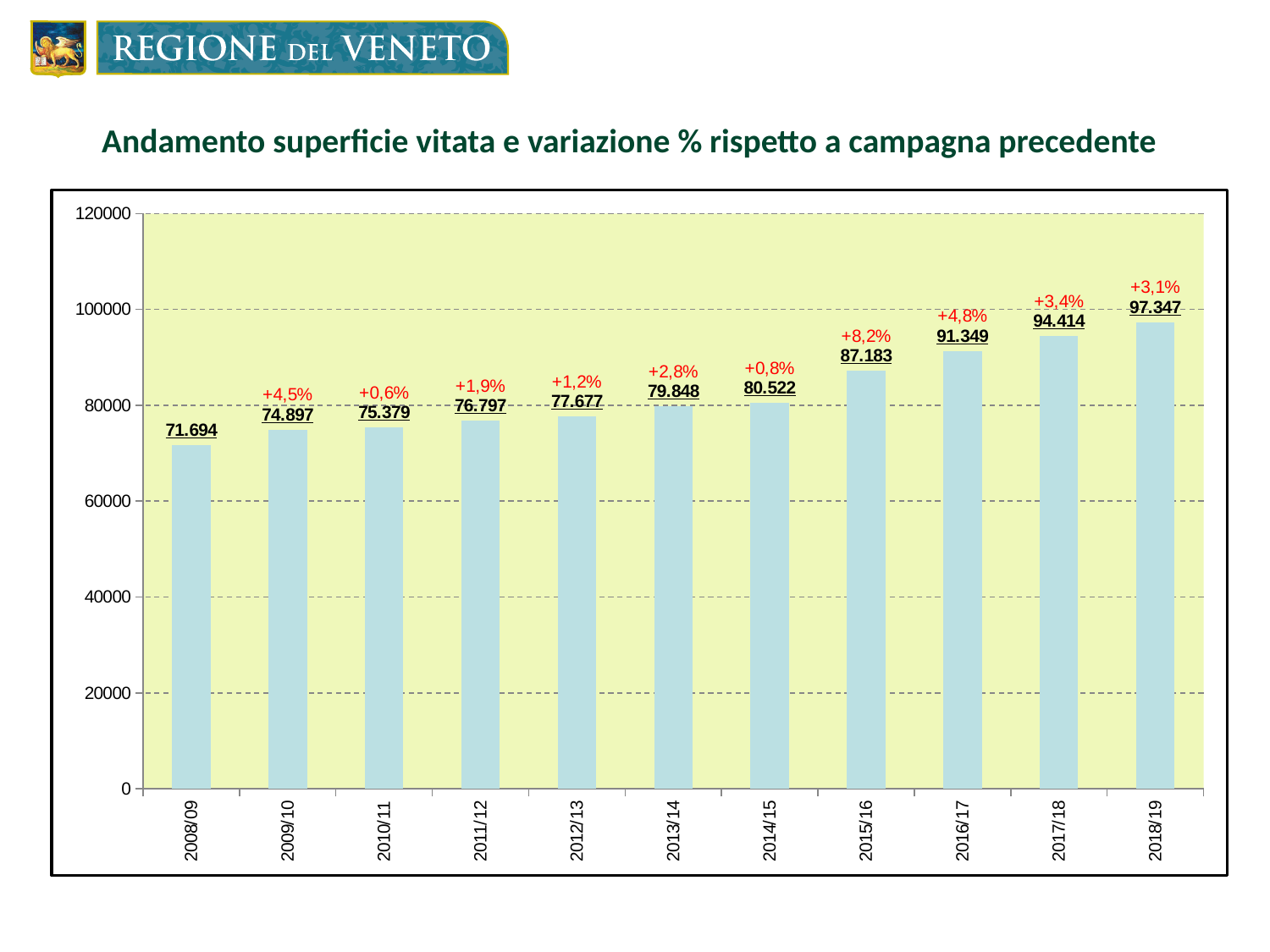
What is the percentage change shown for 2015/16? +8,2% What is the difference between the values for 2018/19 and 2008/09? 25.653 Which campaign has the lowest value? 2008/09 What kind of chart is this? bar chart Is the value for 2017/18 greater or less than 100000? less What is the difference between the values for 2015/16 and 2014/15? 6.661 What is the value for 2008/09? 71.694 Which is larger, the value for 2016/17 or the value for 2013/14? 2016/17 Do the values rise or fall from 2008/09 to 2018/19? rise How many campaigns are shown on the x axis? 11 What is the value for 2018/19? 97.347 Which campaign has the highest value? 2018/19